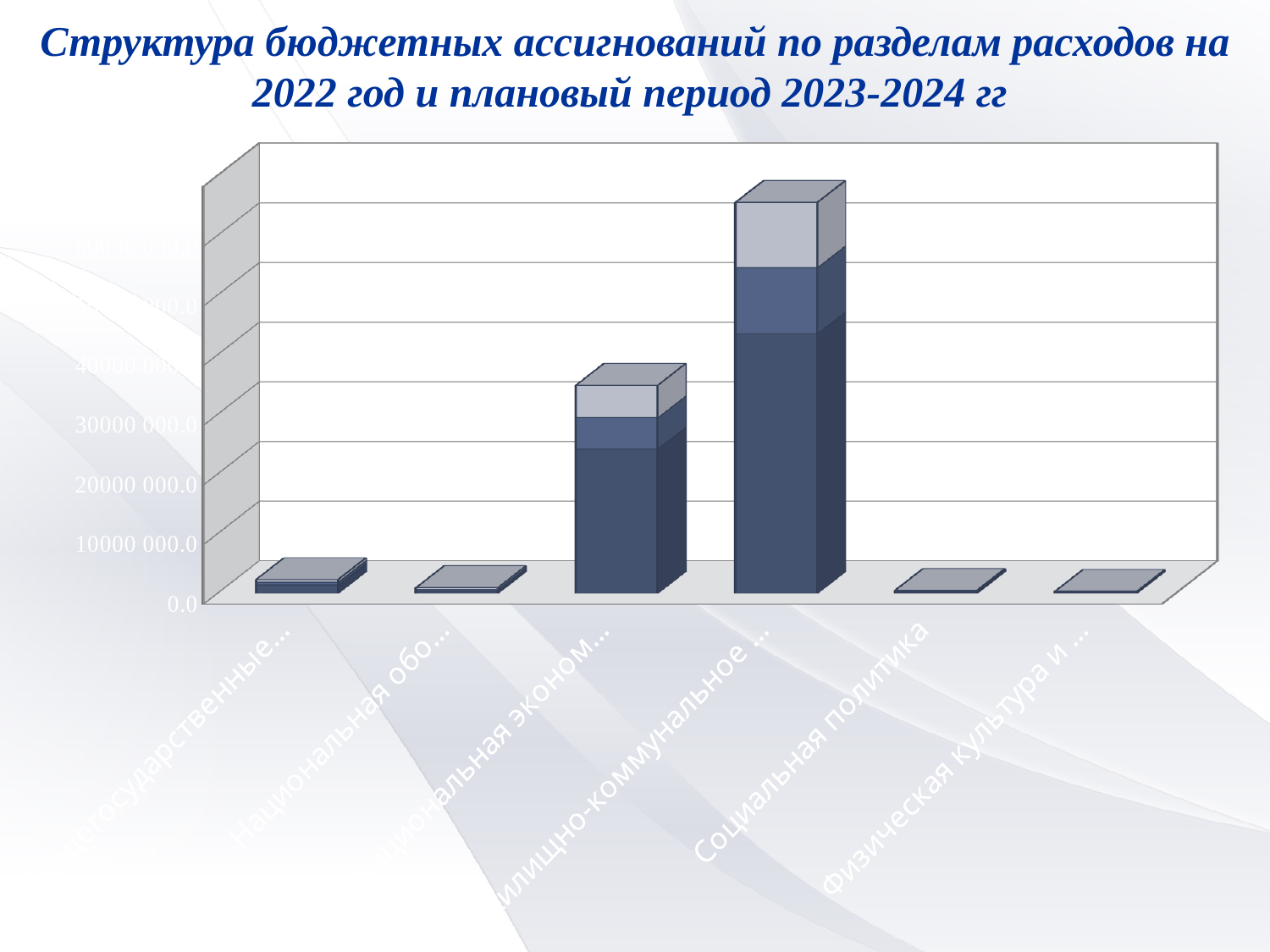
What kind of chart is shown on the slide? bar chart Is the value for Социальная политика greater or less than 10000 000.0? less Is the value for Общегосударственные... greater or less than 10000 000.0? less What is the title of the slide containing the chart? Структура бюджетных ассигнований по разделам расходов на 2022 год и плановый период 2023-2024 гг Is the total value for Жилищно-коммунальное ... greater or less than 40000 000.0? greater Which category has the tallest bar in the chart? Жилищно-коммунальное ... How many stacked segments make up the tallest bar in the chart? 3 Which bar is taller: Жилищно-коммунальное ... or Национальная эконом...? Жилищно-коммунальное ... How many categories are plotted along the x axis of the chart? 6 Which bar is taller: Национальная эконом... or Национальная обо...? Национальная эконом...